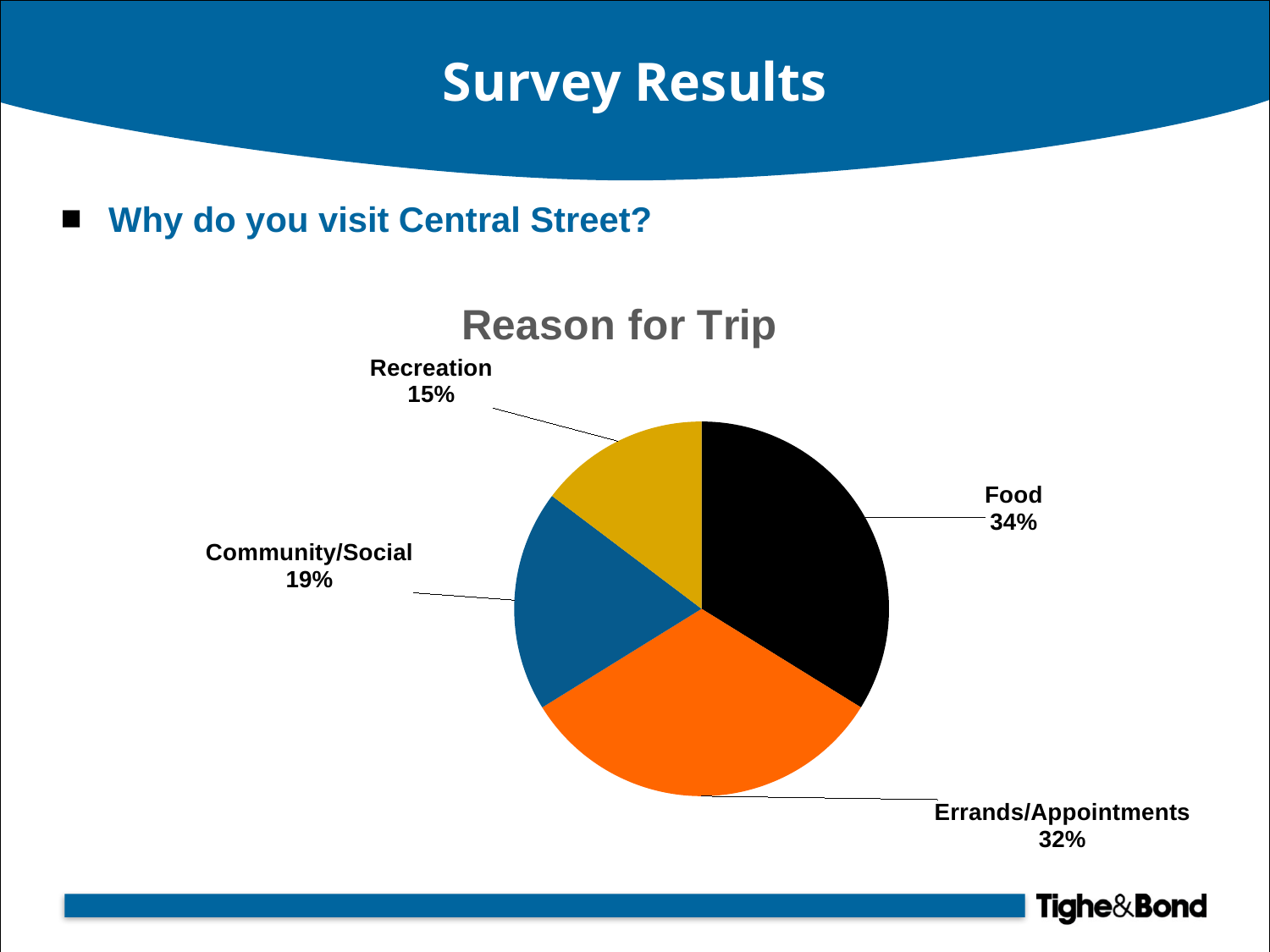
What colour is the Errands/Appointments slice? orange What share of trips is for Community/Social? 19% What is the difference in percentage points between Food and Recreation? 19 What is the title of the chart? Reason for Trip Which reason for trip has the smallest share? Recreation How many slices does the pie chart have? 4 What share of trips is for Recreation? 15% Which reason for trip has the largest share? Food What type of chart is shown on the slide? pie chart What share of trips is for Errands/Appointments? 32% What share of trips is for Food? 34% Which is larger, the share for Community/Social or the share for Recreation? Community/Social